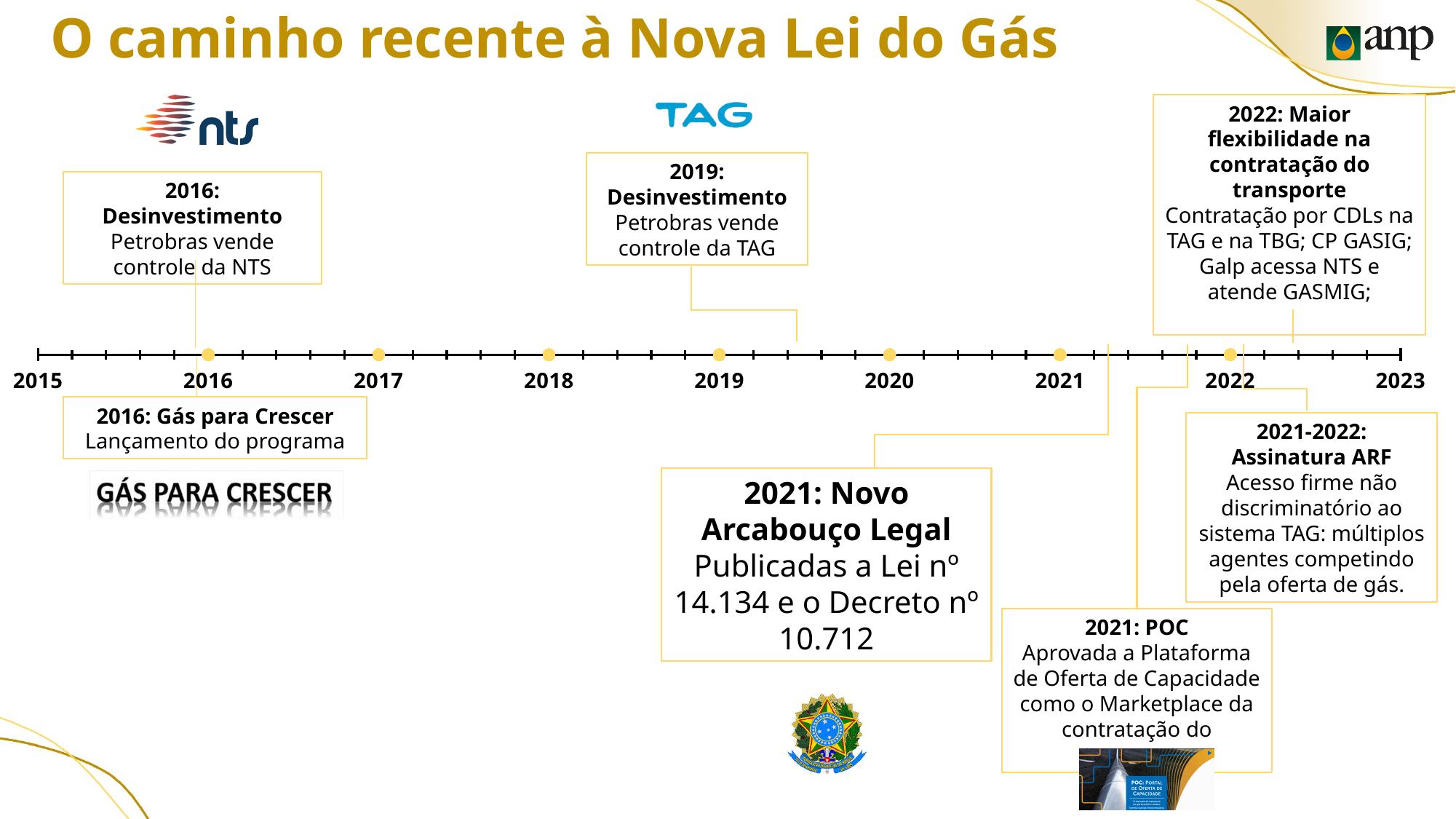
In which year does the timeline place the 'Novo Arcabouço Legal' event? 2021 What is the first year labelled on the timeline axis? 2015 Which decree number is cited in the 2021 'Novo Arcabouço Legal' box on the timeline? Decreto nº 10.712 What is the title of the slide containing the timeline? O caminho recente à Nova Lei do Gás Which year on the timeline is marked with the event 'Desinvestimento: Petrobras vende controle da TAG'? 2019 What is the last year labelled on the timeline axis? 2023 How many years separate the 'Desinvestimento' of NTS and the 'Desinvestimento' of TAG on the timeline? 3 How many yellow marker dots are placed on the timeline? 7 How many year labels are shown along the timeline axis? 9 Which year on the timeline is marked with the event 'Gás para Crescer: Lançamento do programa'? 2016 Which law number is cited in the 2021 'Novo Arcabouço Legal' box on the timeline? Lei nº 14.134 What kind of chart is shown on the slide? Timeline